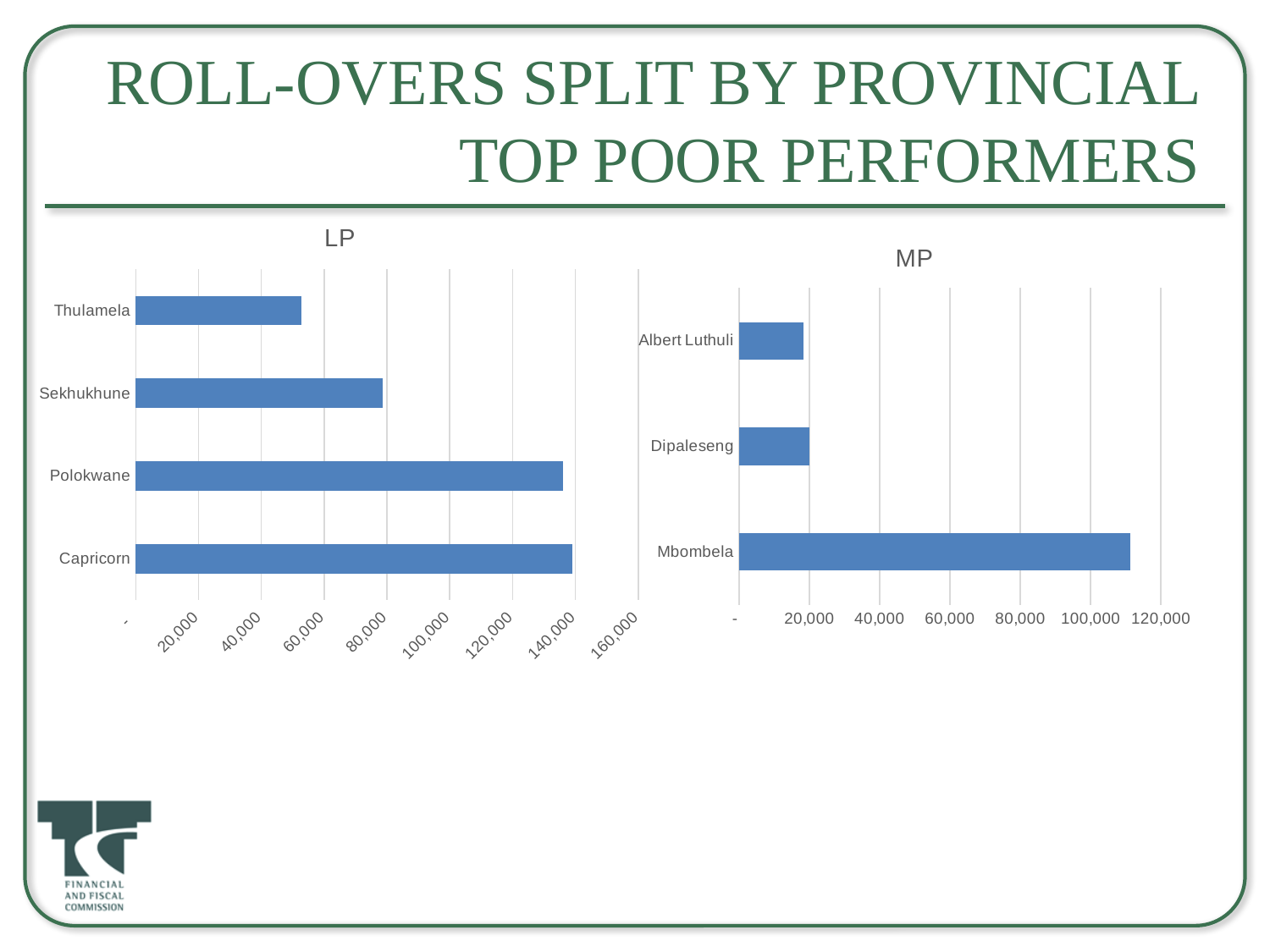
In the LP chart, which is larger, the value for Sekhukhune or the value for Thulamela? Sekhukhune In the LP chart, is the value for Polokwane greater or less than 120,000? greater In the MP chart, which is larger, the value for Mbombela or the value for Dipaleseng? Mbombela In the LP chart, which category has the lowest value? Thulamela In the LP chart, is the value for Sekhukhune greater or less than 60,000? greater In the MP chart, is the value for Mbombela greater or less than 100,000? greater In the MP chart, which category has the highest value? Mbombela How many categories are shown in the MP chart? 3 How many categories are shown in the LP chart? 4 What kind of chart is the LP chart? bar chart What is the title of the chart on the right side of the slide? MP